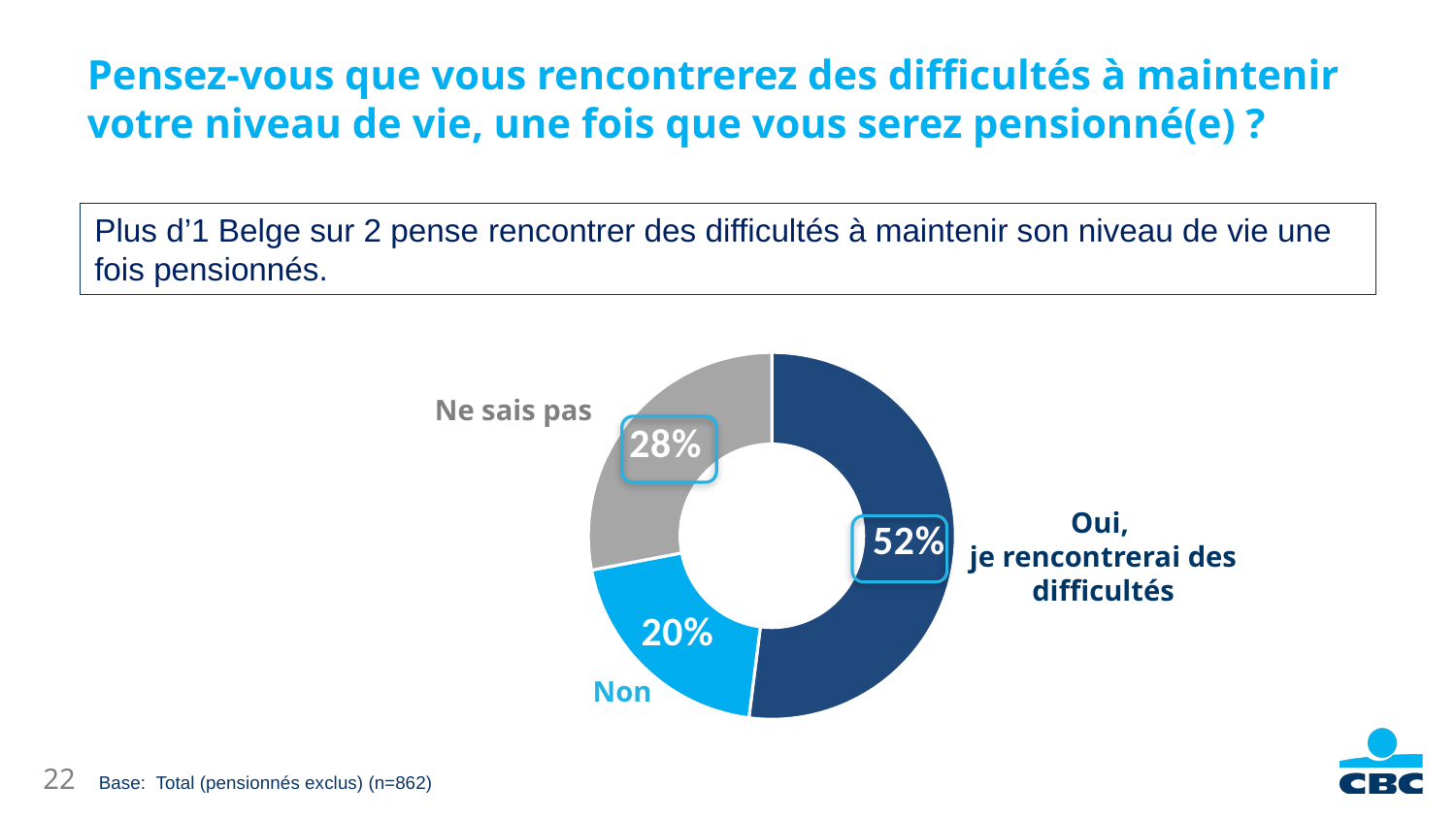
What colour is the "Non" slice of the chart? Light blue Which response has the largest share of the chart? Oui, je rencontrerai des difficultés What is the base (sample size) indicated at the bottom of the slide? n=862 What is the difference in percentage points between "Ne sais pas" and "Non"? 8 What percentage of respondents answered "Non"? 20% What percentage of respondents answered "Ne sais pas"? 28% What percentage of respondents answered "Oui, je rencontrerai des difficultés"? 52% How many response categories are shown in the chart? 3 What is the difference in percentage points between "Oui, je rencontrerai des difficultés" and "Non"? 32 What kind of chart is shown on the slide? Doughnut (pie) chart Which is larger: the share for "Ne sais pas" or the share for "Non"? Ne sais pas Which response has the smallest share of the chart? Non